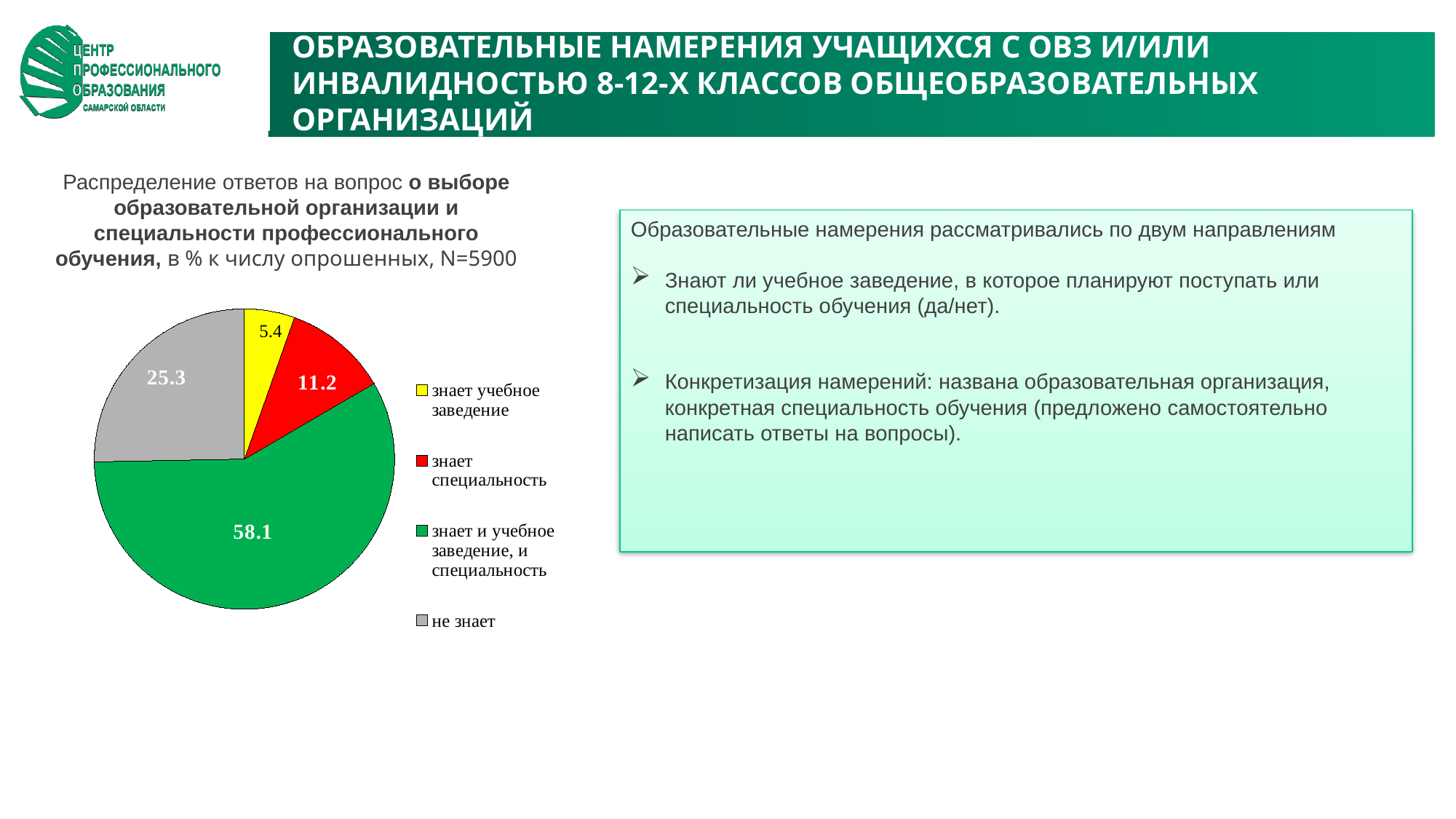
What is the value for "знает и учебное заведение, и специальность"? 58.1 How many slices does the pie chart have? 4 What is the value for "знает учебное заведение"? 5.4 What kind of chart is shown on the slide? pie chart What is the value for "не знает"? 25.3 What is the sample size (N) stated in the chart title? N=5900 Which category has the largest share of the pie? знает и учебное заведение, и специальность What colour is the slice for "не знает"? grey Which is larger: the value for "не знает" or the value for "знает специальность"? не знает What is the value for "знает специальность"? 11.2 What is the difference between the values for "не знает" and "знает специальность"? 14.1 Which category has the smallest share of the pie? знает учебное заведение